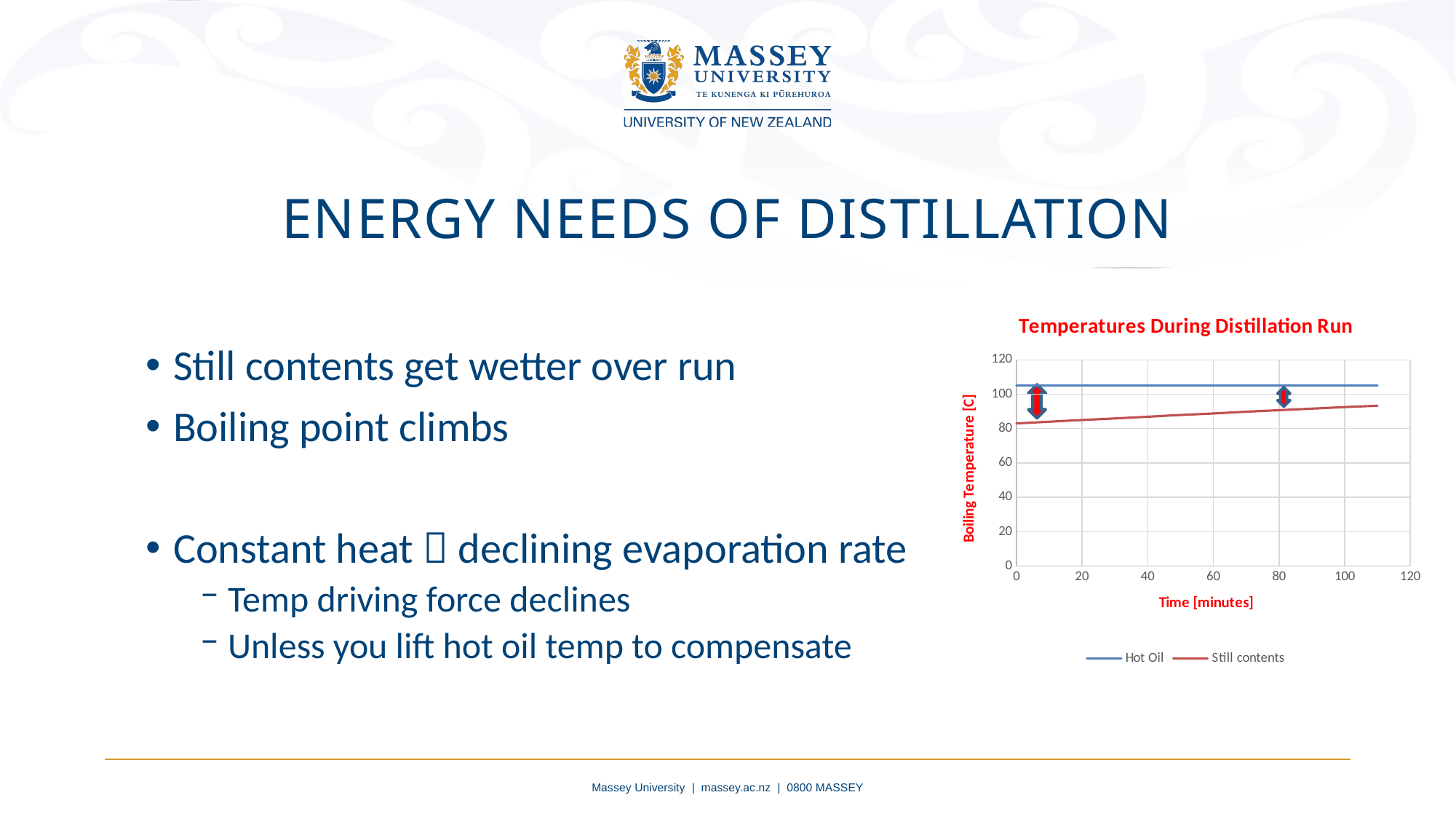
Is the Still contents temperature at time 0 greater or less than 100? less Is the Still contents temperature at time 0 greater or less than 60? greater Is the Still contents temperature at 100 minutes greater or less than 80? greater Does the Hot Oil line rise, fall, or stay flat as time increases? stay flat Does the Still contents line rise or fall as time increases? rise Which series has the higher temperature throughout the run, Hot Oil or Still contents? Hot Oil What kind of chart is shown on the slide? line chart What is the label of the x axis of the chart? Time [minutes] Which series is lower at 80 minutes, Hot Oil or Still contents? Still contents What is the title of the chart? Temperatures During Distillation Run How many series does the legend of the chart list? 2